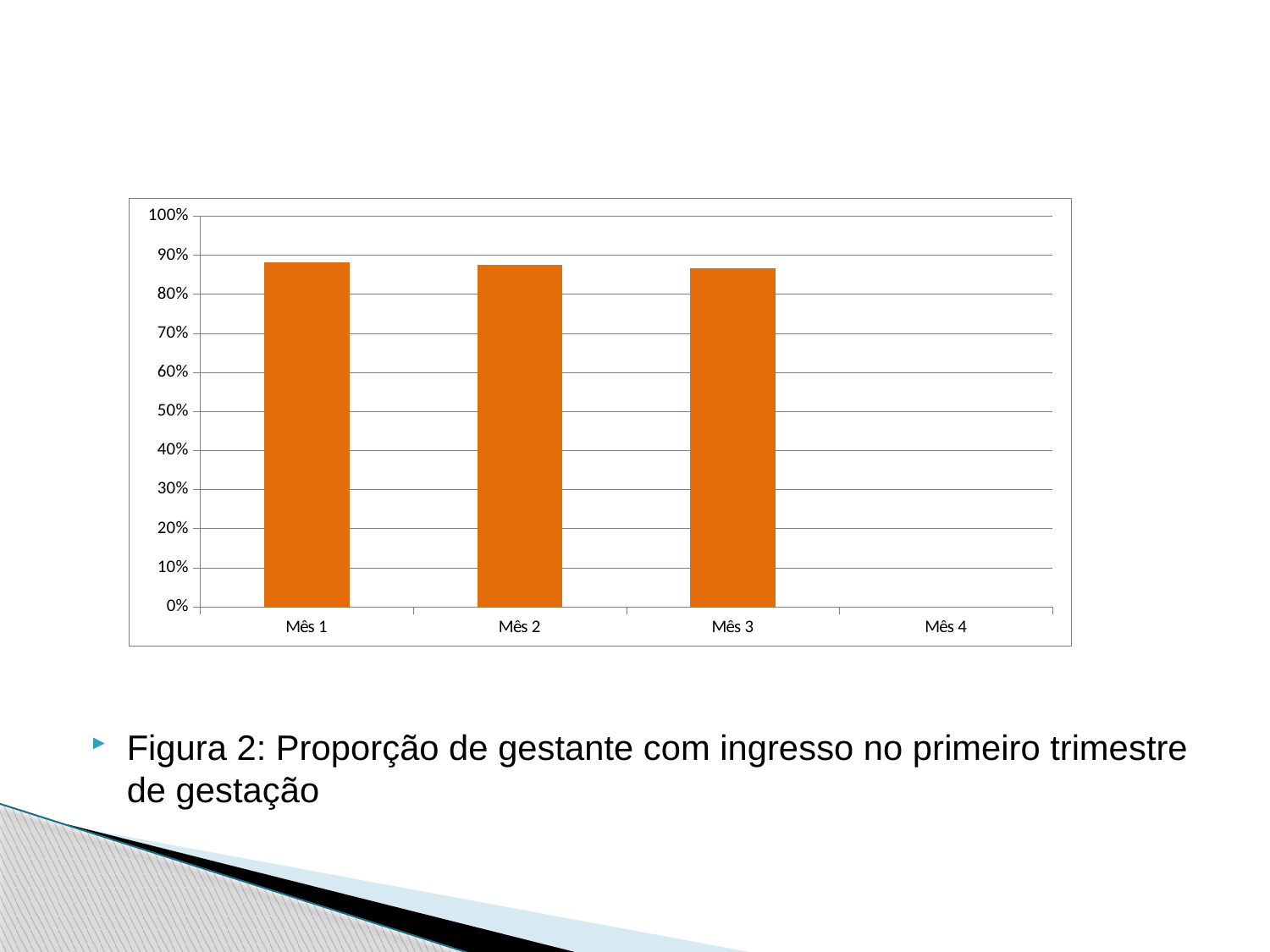
Do the bar values rise or fall from Mês 1 to Mês 3? fall Is the value for Mês 3 greater or less than 90%? less Is the value for Mês 1 greater or less than 90%? less Is the value for Mês 2 greater or less than 80%? greater What kind of chart is shown on the slide? bar chart Which is larger, the value for Mês 1 or the value for Mês 4? Mês 1 What is the highest value shown on the y axis of the chart? 100% Which category has no bar plotted in the chart? Mês 4 How many categories are shown on the x axis of the chart? 4 Which category has the lowest value in the chart? Mês 4